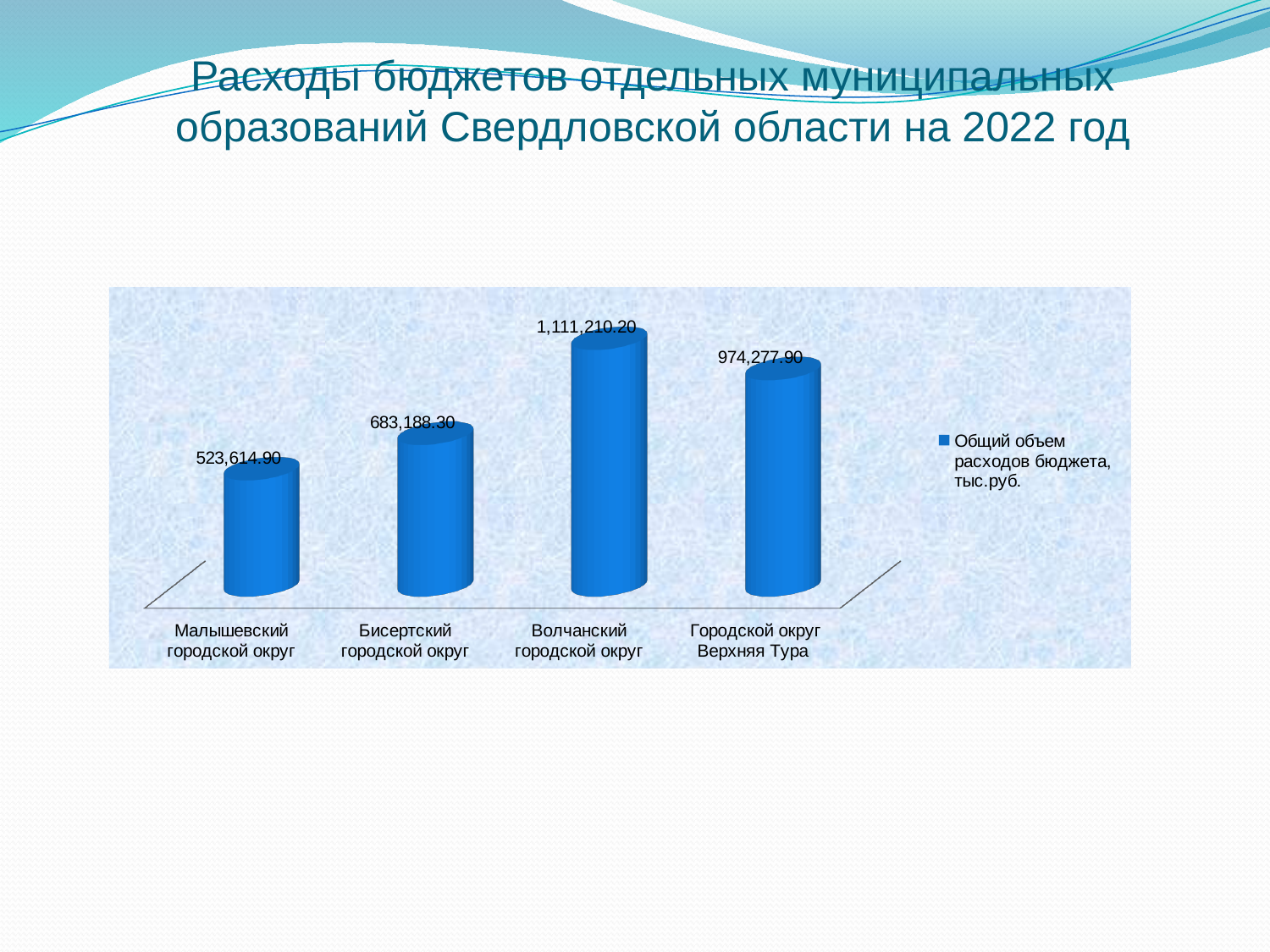
What kind of chart is shown on the slide? Bar chart How many categories are shown in the chart? 4 Which category has the highest value? Волчанский городской округ Which is larger, the value for Городской округ Верхняя Тура or the value for Бисертский городской округ? Городской округ Верхняя Тура What is the value for Малышевский городской округ? 523,614.90 What series name does the legend show? Общий объем расходов бюджета, тыс.руб. What is the value for Волчанский городской округ? 1,111,210.20 What is the difference between the values for Бисертский городской округ and Малышевский городской округ? 159,573.40 Which category has the lowest value? Малышевский городской округ What is the value for Бисертский городской округ? 683,188.30 What is the difference between the values for Волчанский городской округ and Городской округ Верхняя Тура? 136,932.30 What is the value for Городской округ Верхняя Тура? 974,277.90